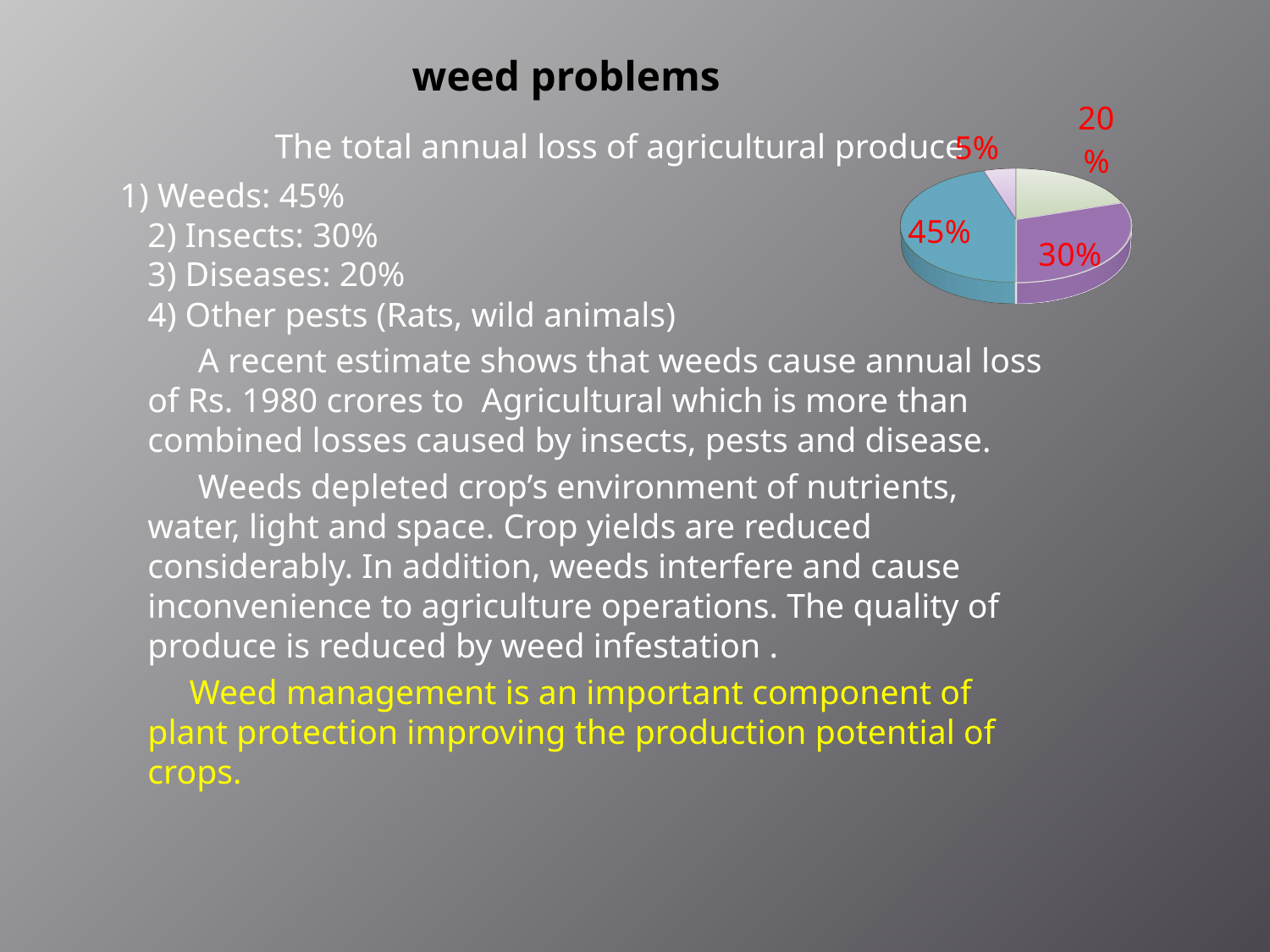
What is the combined share of the 30% and 20% slices in the pie chart? 50% What is the largest slice of the pie chart? 45% According to the slide, which cause of agricultural loss corresponds to the 45% slice of the pie chart? Weeds Does the pie chart have a legend? No How many slices does the pie chart have? 4 What kind of chart is shown on the slide? pie chart What is the smallest slice of the pie chart? 5% Which is larger in the pie chart, the blue slice or the purple slice? the blue slice (45%) What percentage is shown on the blue slice of the pie chart? 45% What percentage is shown on the light green slice of the pie chart? 20% What is the difference between the largest and the second-largest slices of the pie chart? 15% What percentage is shown on the purple slice of the pie chart? 30%